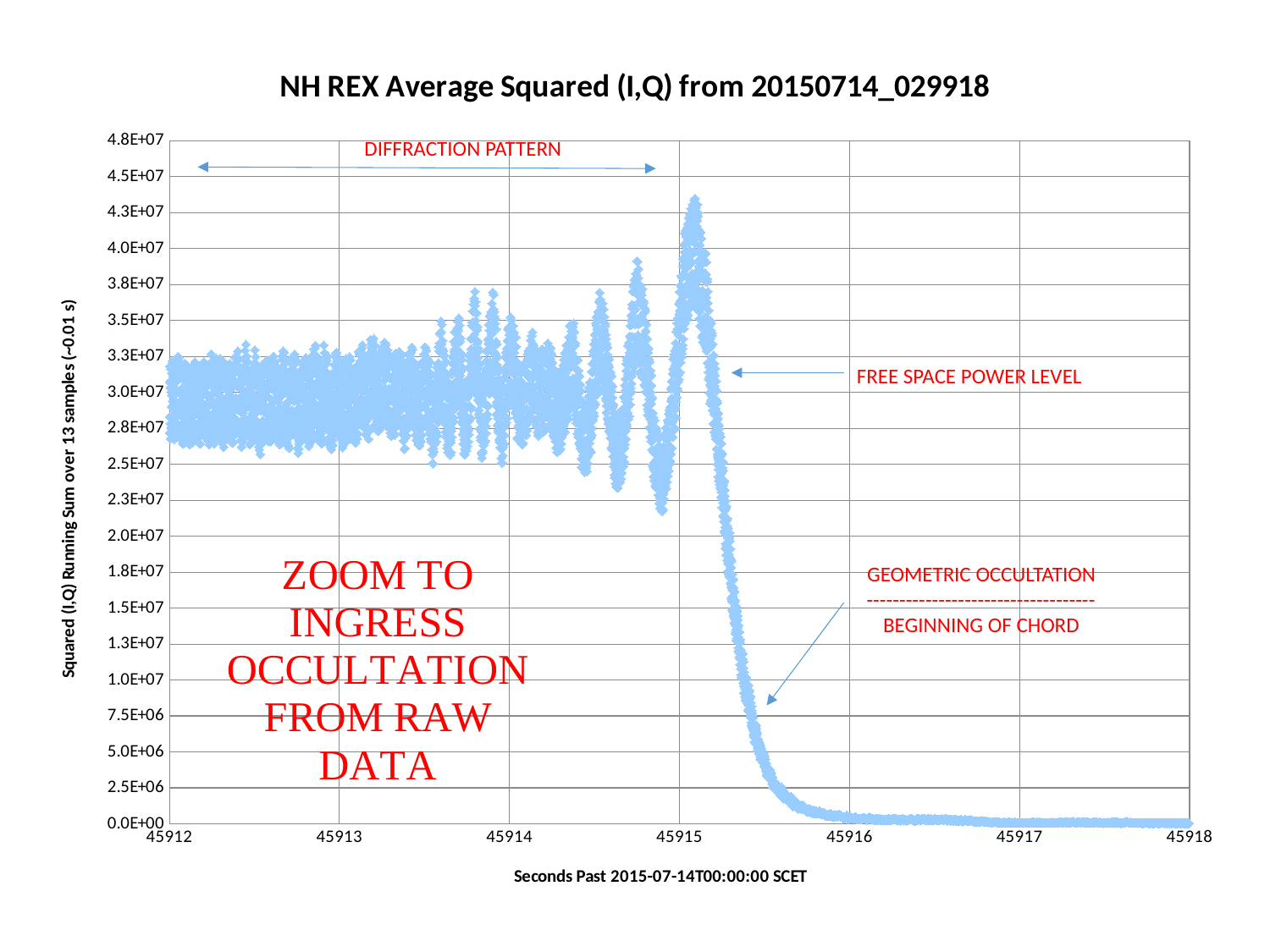
Is the plotted value at x = 45916 greater or less than 5.0E+06? less What is the label of the x axis? Seconds Past 2015-07-14T00:00:00 SCET What is the title of the chart? NH REX Average Squared (I,Q) from 20150714_029918 Is the plotted value at x = 45912 greater or less than 2.0E+07? greater Which has the larger plotted value: x = 45913 or x = 45917? 45913 Which has the larger plotted value: x = 45914 or x = 45916? 45914 Overall, do the plotted values rise or fall as the x axis goes from 45912 to 45918? fall Is the plotted value at x = 45918 greater or less than 2.5E+06? less What kind of chart is shown on the slide? scatter chart